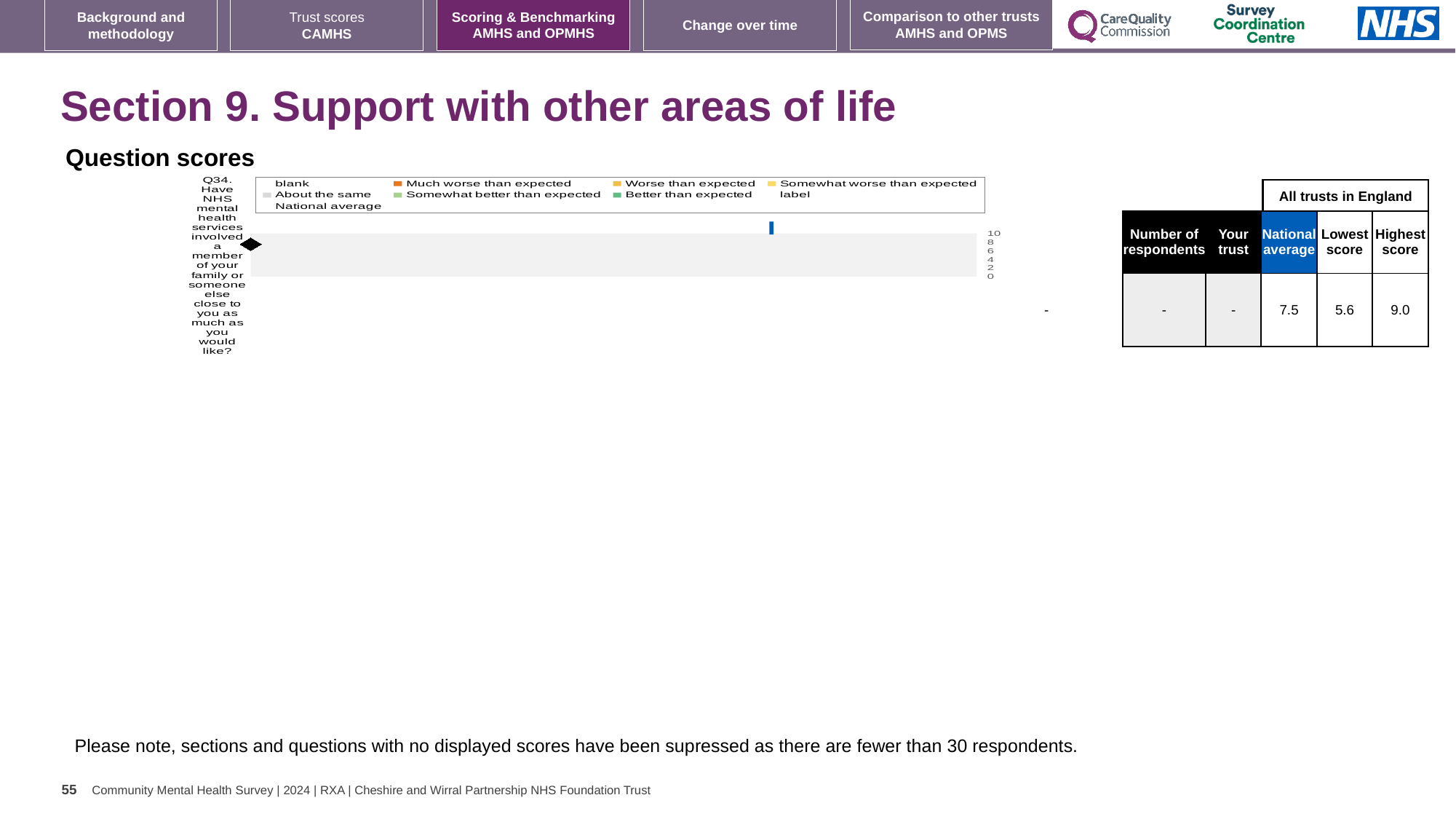
What is the difference between the highest score and the lowest score shown in the table for Q34? 3.4 In the table next to the chart, what is the national average score for Q34? 7.5 Is the national average score for Q34 in the table greater or less than 7? greater Which is larger in the table for Q34: the national average or the lowest score? National average Which question number is plotted on the chart? Q34 How many questions (categories) are plotted on the chart? 1 In the table next to the chart, what is the highest score among all trusts in England for Q34? 9.0 What is the highest value shown on the chart's score axis? 10 What kind of chart is shown under 'Question scores'? bar chart In the table next to the chart, what is the lowest score among all trusts in England for Q34? 5.6